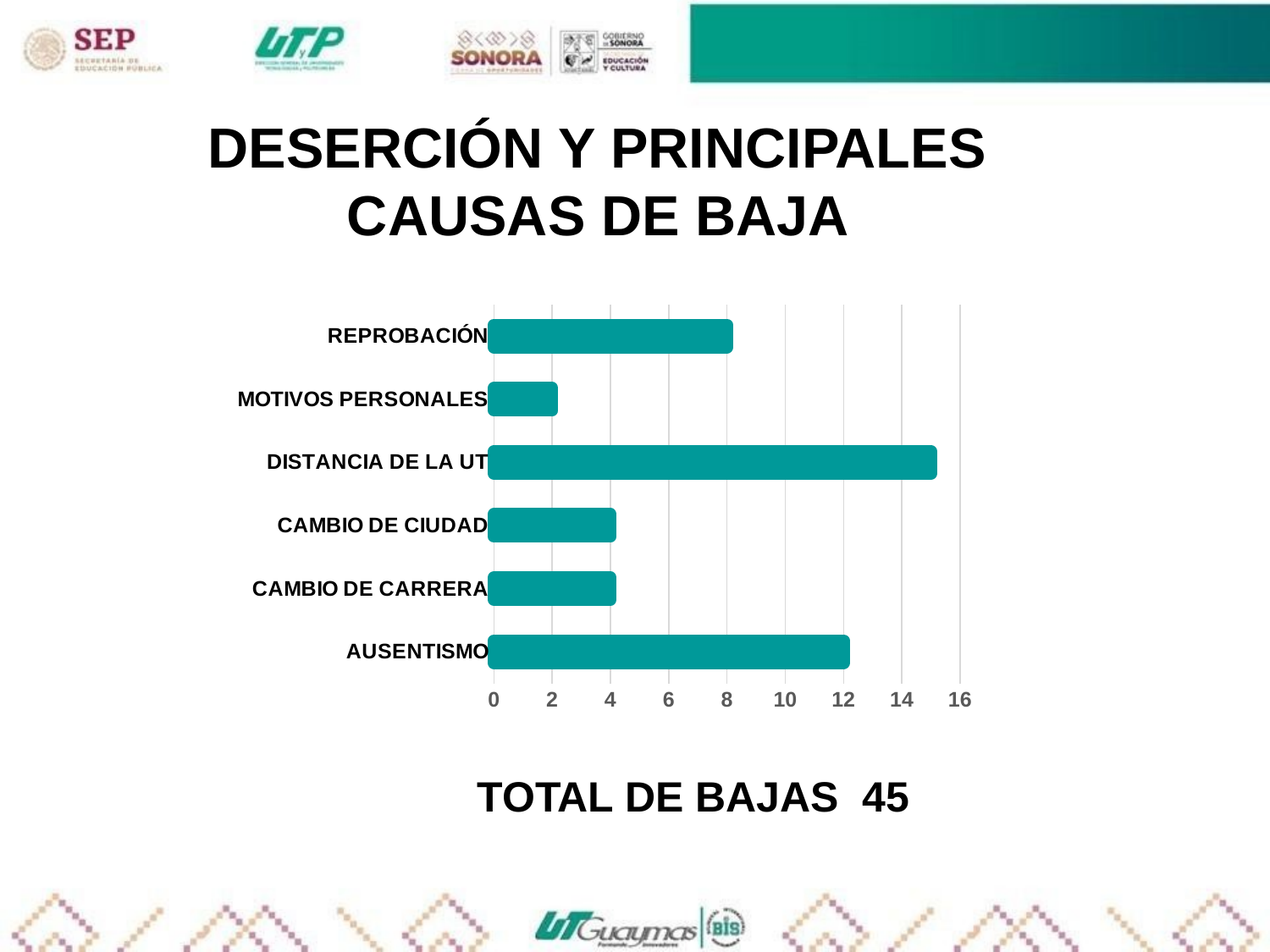
Is the value for REPROBACIÓN greater or less than 6? greater Is the value for DISTANCIA DE LA UT greater or less than 14? greater Is the value for CAMBIO DE CIUDAD greater or less than 6? less Which is larger, the value for AUSENTISMO or the value for REPROBACIÓN? AUSENTISMO Which is larger, the value for DISTANCIA DE LA UT or the value for AUSENTISMO? DISTANCIA DE LA UT What total number of dropouts (TOTAL DE BAJAS) is stated below the chart? 45 How many causes of dropout (categories) are plotted in the chart? 6 Which category has the lowest value in the chart? MOTIVOS PERSONALES Which category has the highest value in the chart? DISTANCIA DE LA UT What kind of chart is shown on the slide? bar chart